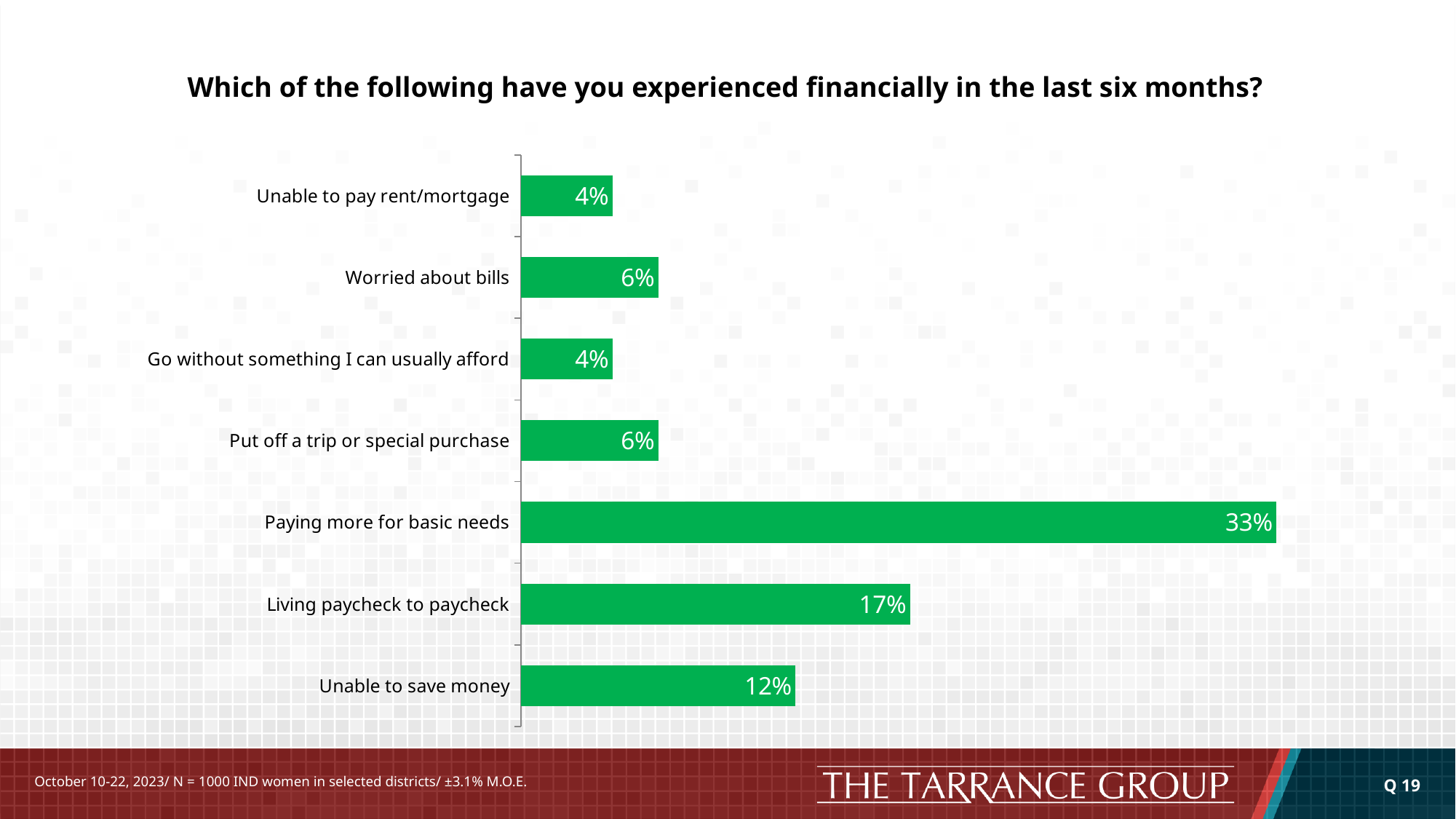
How many categories are shown in the chart? 7 What is the difference between 'Paying more for basic needs' and 'Living paycheck to paycheck'? 16% What is the value for 'Worried about bills'? 6% What is the title of the chart? Which of the following have you experienced financially in the last six months? Which category has the highest value? Paying more for basic needs Which is larger, 'Unable to save money' or 'Put off a trip or special purchase'? Unable to save money What percentage of respondents reported paying more for basic needs? 33% What kind of chart is shown on the slide? Bar chart What is the difference between 'Living paycheck to paycheck' and 'Unable to save money'? 5% What is the value for 'Living paycheck to paycheck'? 17% What is the value for 'Unable to save money'? 12% What colour are the bars in the chart? Green